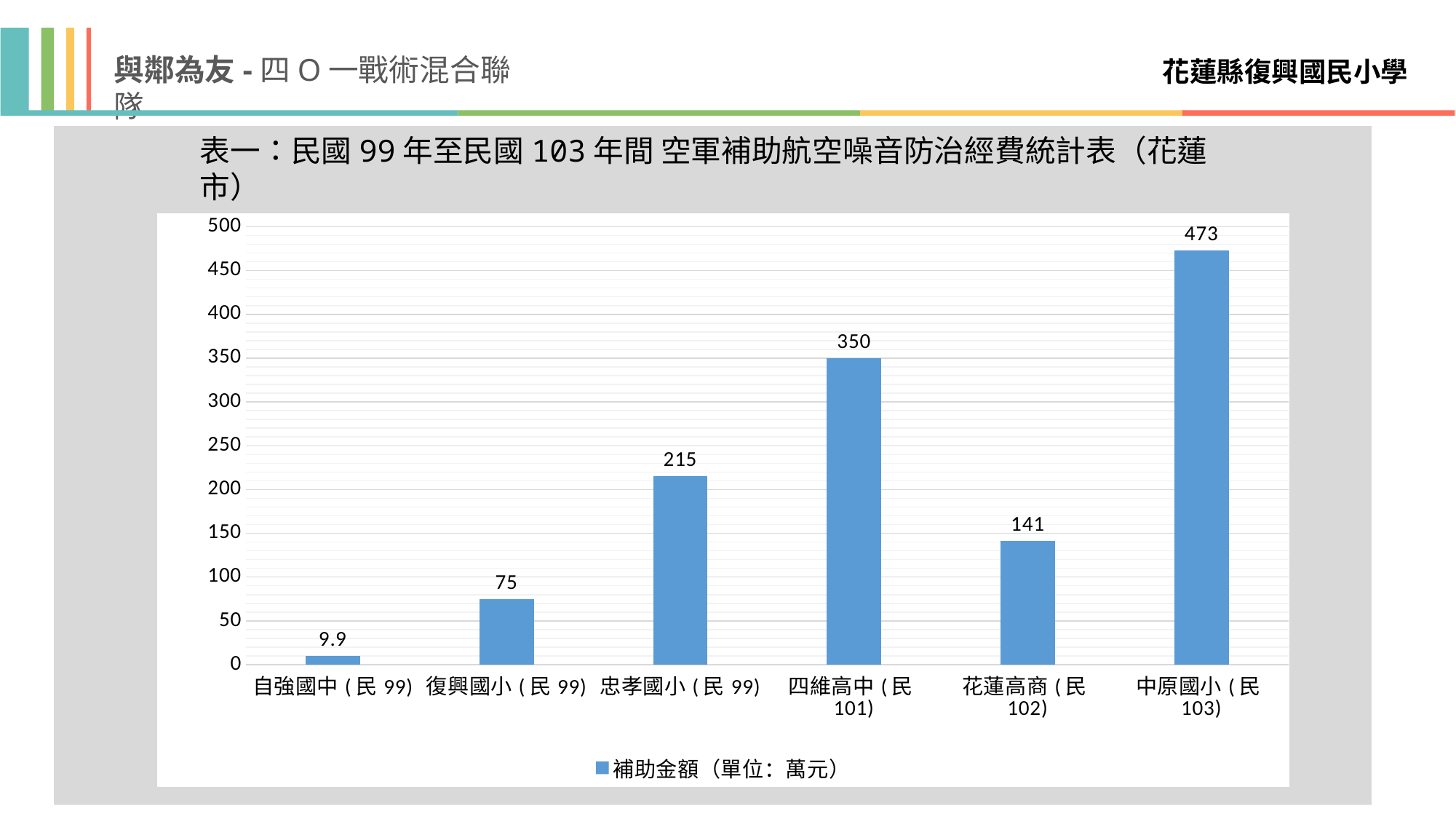
What is the value for 自強國中 (民 99)? 9.9 What kind of chart is shown? bar chart What is the value for 中原國小 (民 103)? 473 Which category has the highest value? 中原國小 (民 103) How many series does the legend list? 1 What is the legend entry for the series? 補助金額（單位：萬元） What is the value for 四維高中 (民 101)? 350 How many categories are shown on the x axis? 6 What is the difference between the values for 四維高中 (民 101) and 忠孝國小 (民 99)? 135 Is the value for 忠孝國小 (民 99) greater or less than 200? greater Which category has the lowest value? 自強國中 (民 99) Which is larger, the value for 花蓮高商 (民 102) or the value for 復興國小 (民 99)? 花蓮高商 (民 102)